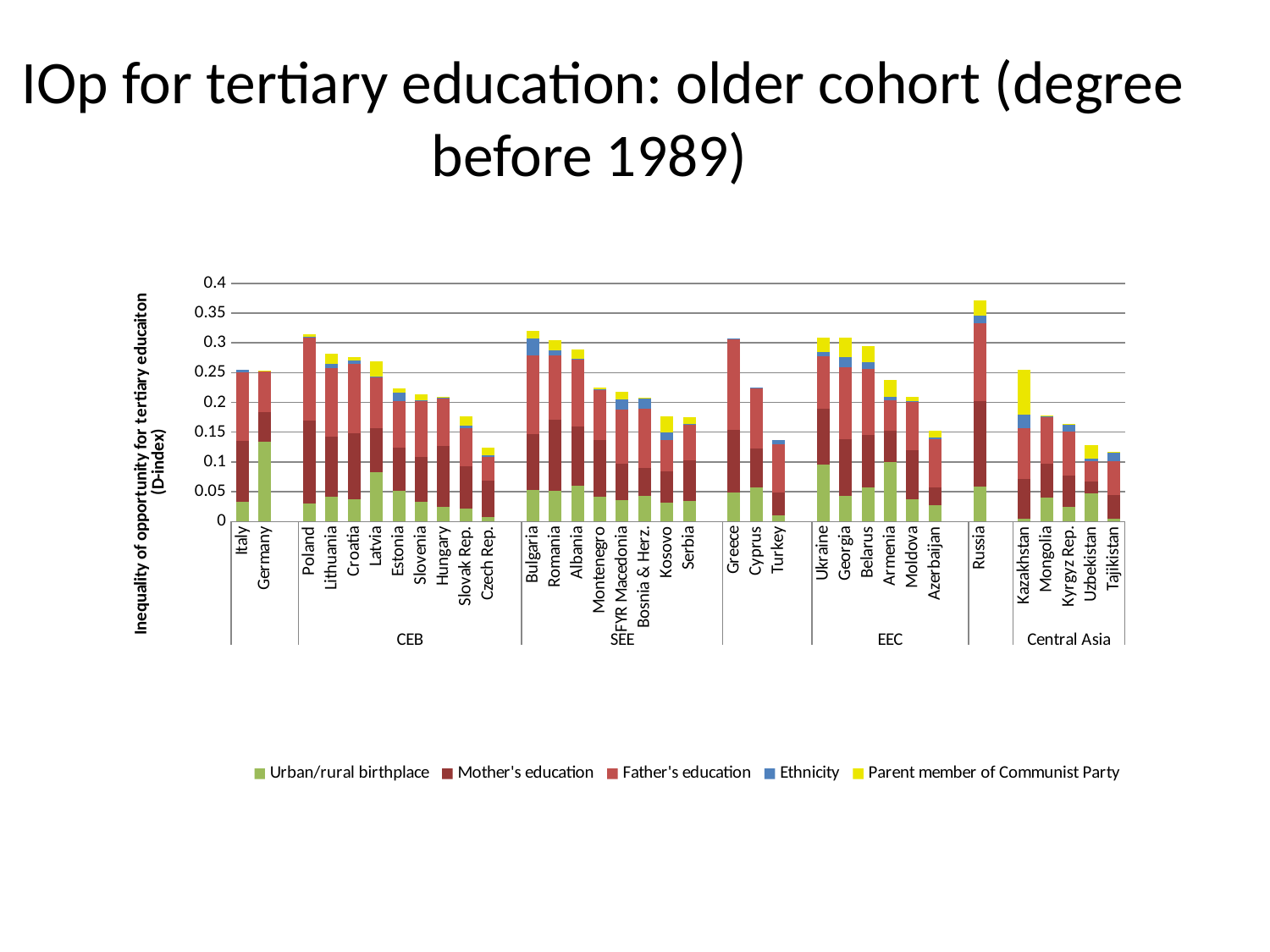
What kind of chart is shown on the slide? Stacked bar chart Which series is shown in yellow in the legend? Parent member of Communist Party Which has the larger total value, Poland or Germany? Poland Is the total value for Czech Rep. greater or less than 0.15? less How many series does the legend list? 5 What is the label on the vertical axis? Inequality of opportunity for tertiary educaiton (D-index) Is the total value for Russia greater or less than 0.35? greater How many countries are plotted along the x axis? 34 Which has the larger total value, Bulgaria or Serbia? Bulgaria Is the total value for Poland greater or less than 0.3? greater Which country has the highest total inequality of opportunity value? Russia